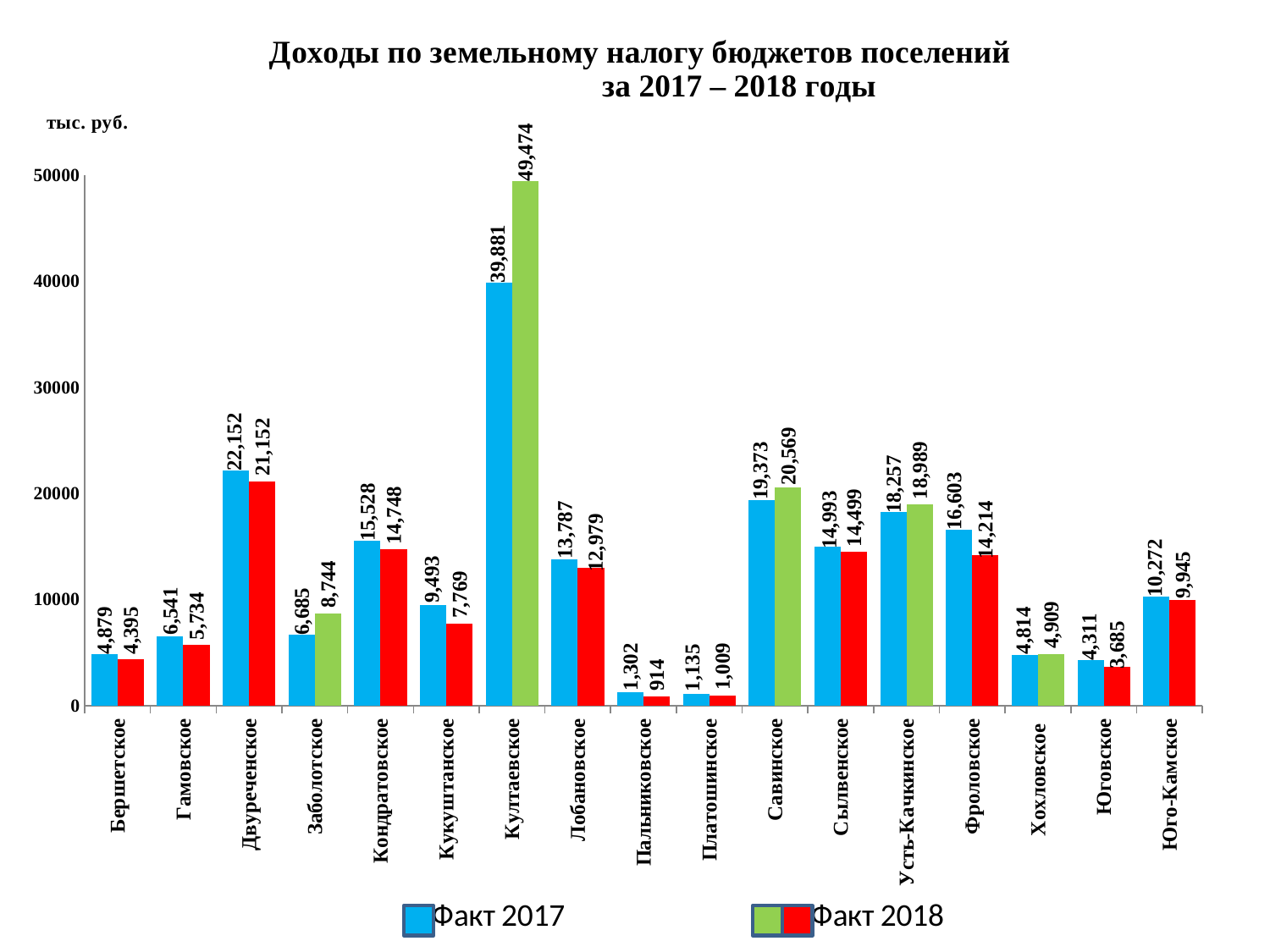
Which settlement has the highest Факт 2018 value? Култаевское What is the difference between the Факт 2017 and Факт 2018 values for Двуреченское? 1,000 What is the Факт 2017 value for Култаевское? 39,881 How many series does the legend list? 2 Which is larger for Фроловское: the Факт 2017 value or the Факт 2018 value? Факт 2017 Which settlement has the lowest Факт 2017 value? Платошинское What type of chart is shown on the slide? bar chart What is the Факт 2018 value for Заболотское? 8,744 What unit is indicated on the vertical axis of the chart? тыс. руб. How many settlements are shown on the x axis? 17 What is the difference between the Факт 2018 and Факт 2017 values for Култаевское? 9,593 What is the Факт 2018 value for Пальниковское? 914